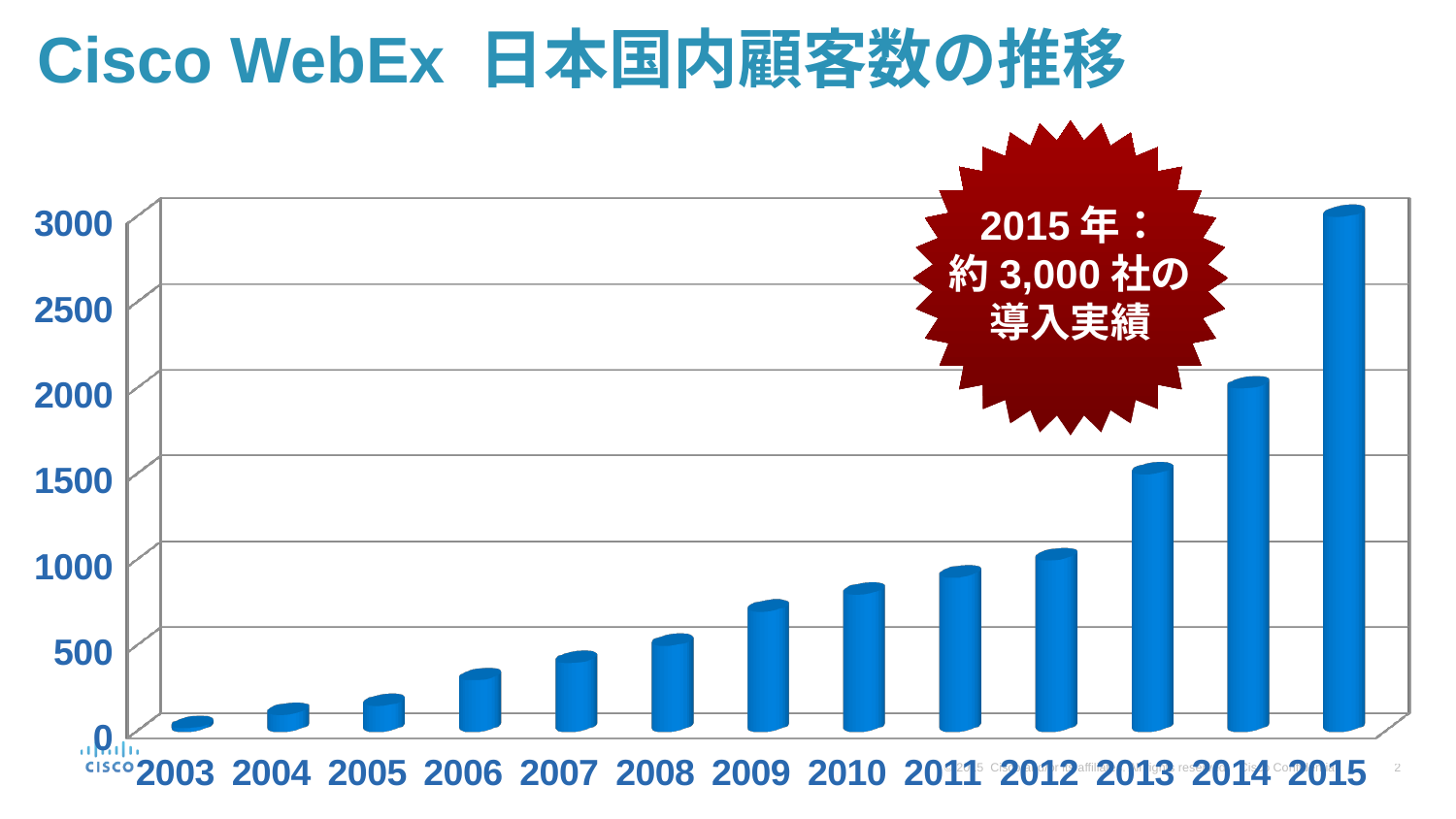
Is the value for 2014 greater or less than 1500? greater Is the value for 2003 greater or less than 500? less Which year has the lowest bar in the chart? 2003 Is the value for 2015 greater or less than 2500? greater Which year has the highest bar in the chart? 2015 What kind of chart is shown on the slide? bar chart How many years are shown on the x axis of the chart? 13 Which is larger, the value for 2013 or the value for 2014? 2014 What is the title of the chart on the slide? Cisco WebEx 日本国内顧客数の推移 Do the values rise or fall from 2003 to 2015? rise